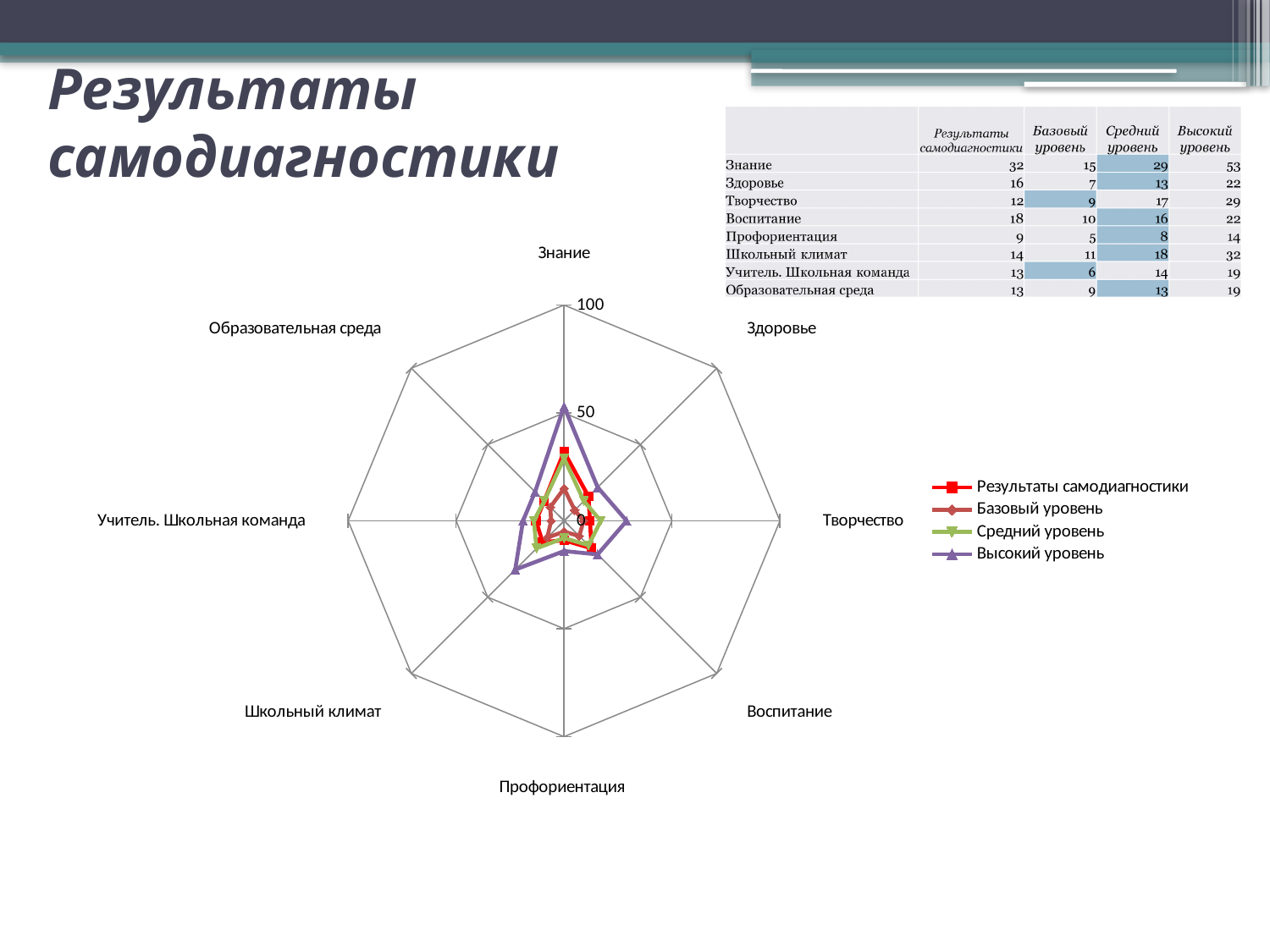
According to the table on the slide, what is the value of Высокий уровень for Школьный климат? 32 Which is larger for Творчество: Результаты самодиагностики or Средний уровень? Средний уровень How many series does the legend of the radar chart list? 4 According to the table on the slide, what is the value of Результаты самодиагностики for Знание? 32 Is the value of Результаты самодиагностики for Знание greater or less than 50 on the radar chart? less For which category does the Высокий уровень series reach its highest value in the radar chart? Знание Using the table values, what is the difference between Высокий уровень and Результаты самодиагностики for Знание? 21 According to the table on the slide, what is the value of Базовый уровень for Профориентация? 5 According to the table, for which category is the Результаты самодиагностики value lowest? Профориентация How many categories (axes) does the radar chart have? 8 Which series is drawn in purple with triangle markers in the radar chart? Высокий уровень What kind of chart is shown on the slide? radar chart